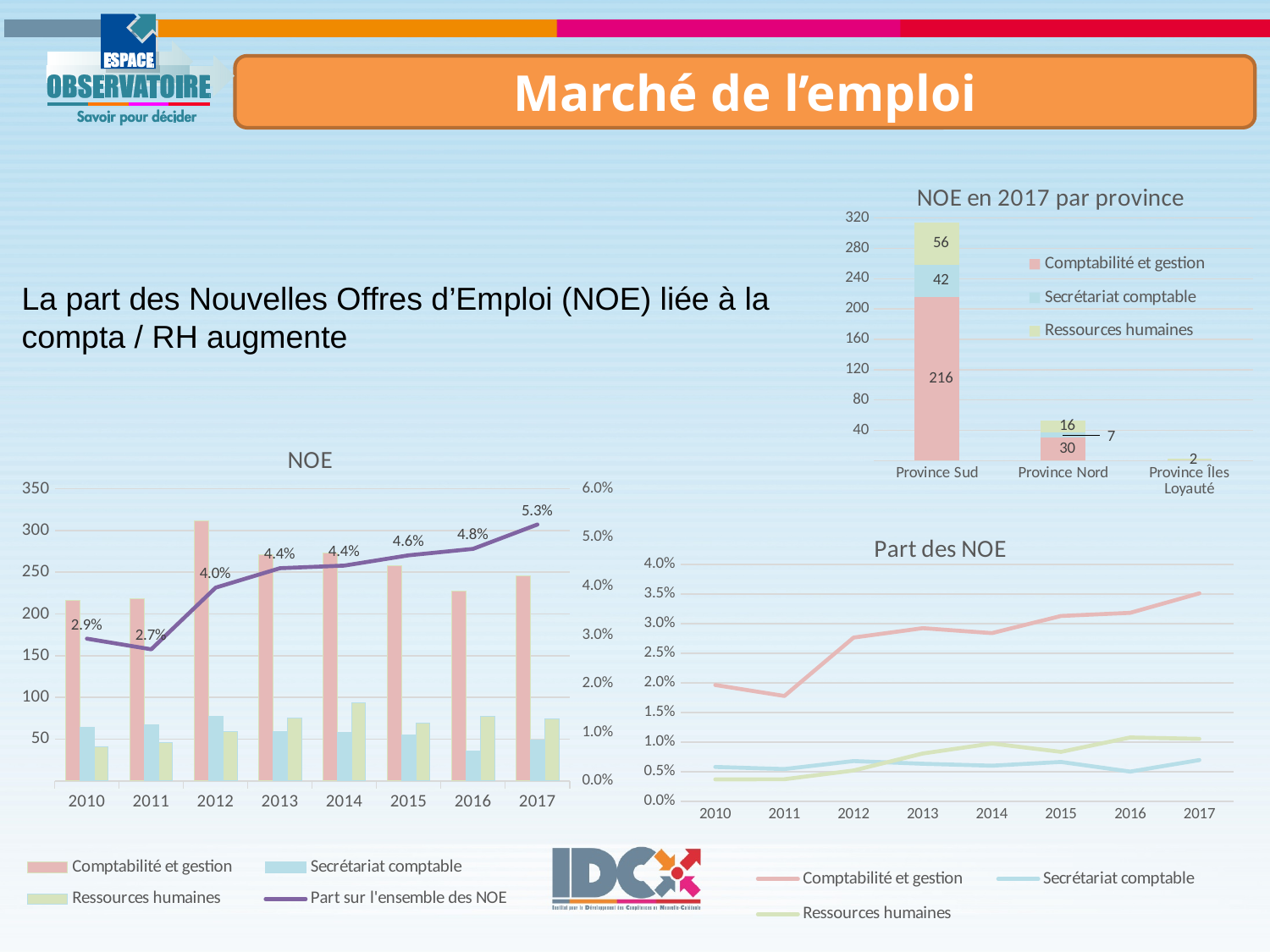
In the 'NOE en 2017 par province' chart, what is the value for 'Comptabilité et gestion' in Province Sud? 216 In the NOE chart, what is the value of 'Part sur l'ensemble des NOE' in 2017? 5.3% In the 'NOE en 2017 par province' chart, what is the total of the stacked bar for Province Nord? 53 In the NOE chart, by how much did 'Part sur l'ensemble des NOE' increase from 2010 to 2017? 2.4% In the NOE chart, which year has the lowest value for 'Part sur l'ensemble des NOE'? 2011 How many series does the legend of the NOE chart list? 4 In the 'NOE en 2017 par province' chart, what is the total of the stacked bar for Province Sud? 314 How many provinces are shown in the 'NOE en 2017 par province' chart? 3 In the NOE chart, is the 'Comptabilité et gestion' bar for 2012 greater or less than 300? greater In the NOE chart, what is the value of 'Part sur l'ensemble des NOE' in 2010? 2.9% In the 'NOE en 2017 par province' chart, which is larger for Province Sud: 'Secrétariat comptable' or 'Ressources humaines'? Ressources humaines In the 'Part des NOE' chart, does the 'Comptabilité et gestion' line rise or fall overall from 2010 to 2017? rise